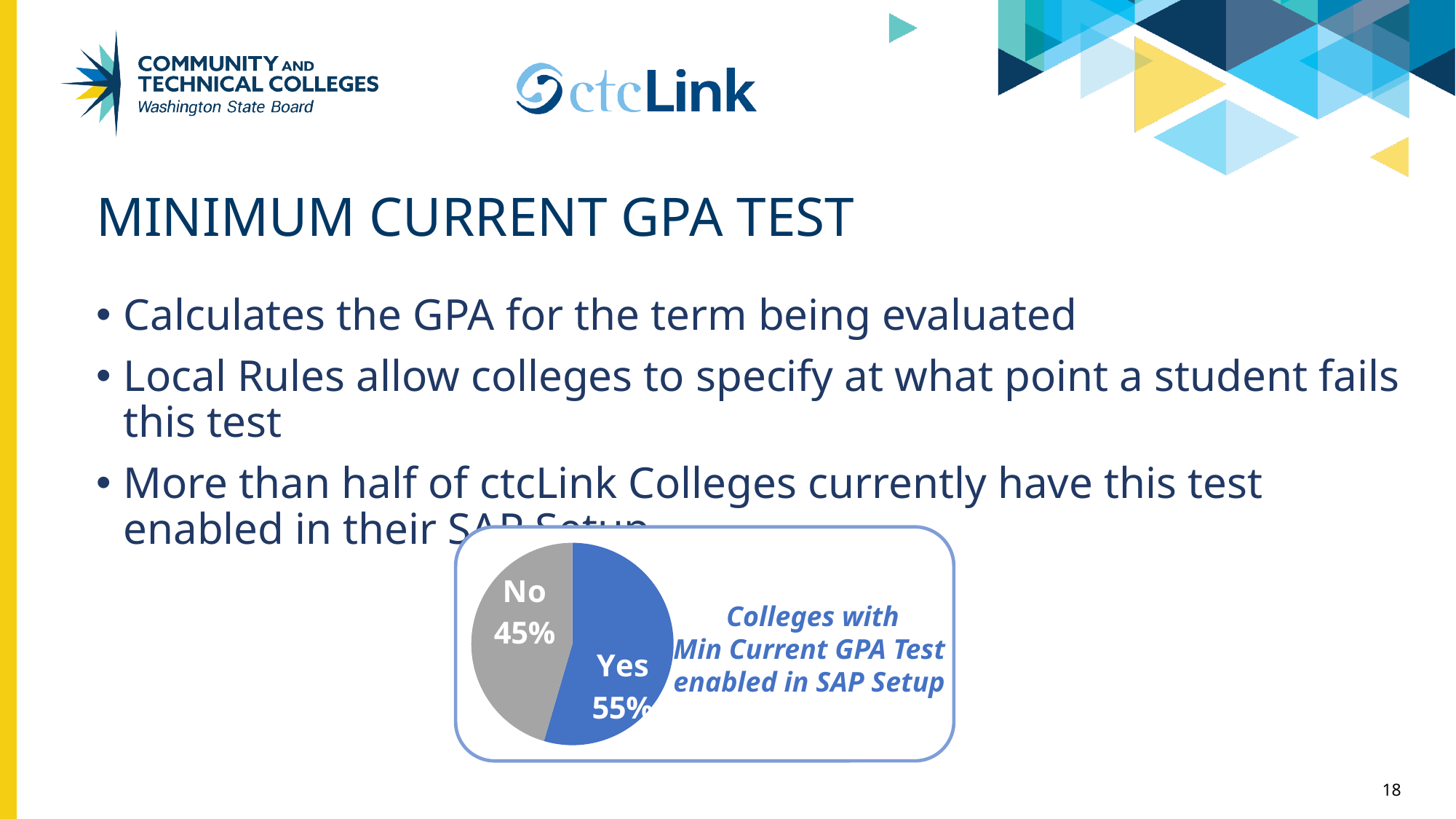
What share of the pie is labelled "Yes"? 55% What share of the pie is labelled "No"? 45% What kind of chart is shown on the slide? pie chart Which is larger, the "Yes" slice or the "No" slice? Yes What colour is the "No" slice of the pie chart? grey Which slice of the pie is the largest? Yes What is the difference in percentage points between the "Yes" and "No" slices? 10 percentage points How many slices does the pie chart have? 2 Is the share for "Yes" greater or less than 50%? greater Which slice of the pie is the smallest? No What is the title of the pie chart? Colleges with Min Current GPA Test enabled in SAP Setup